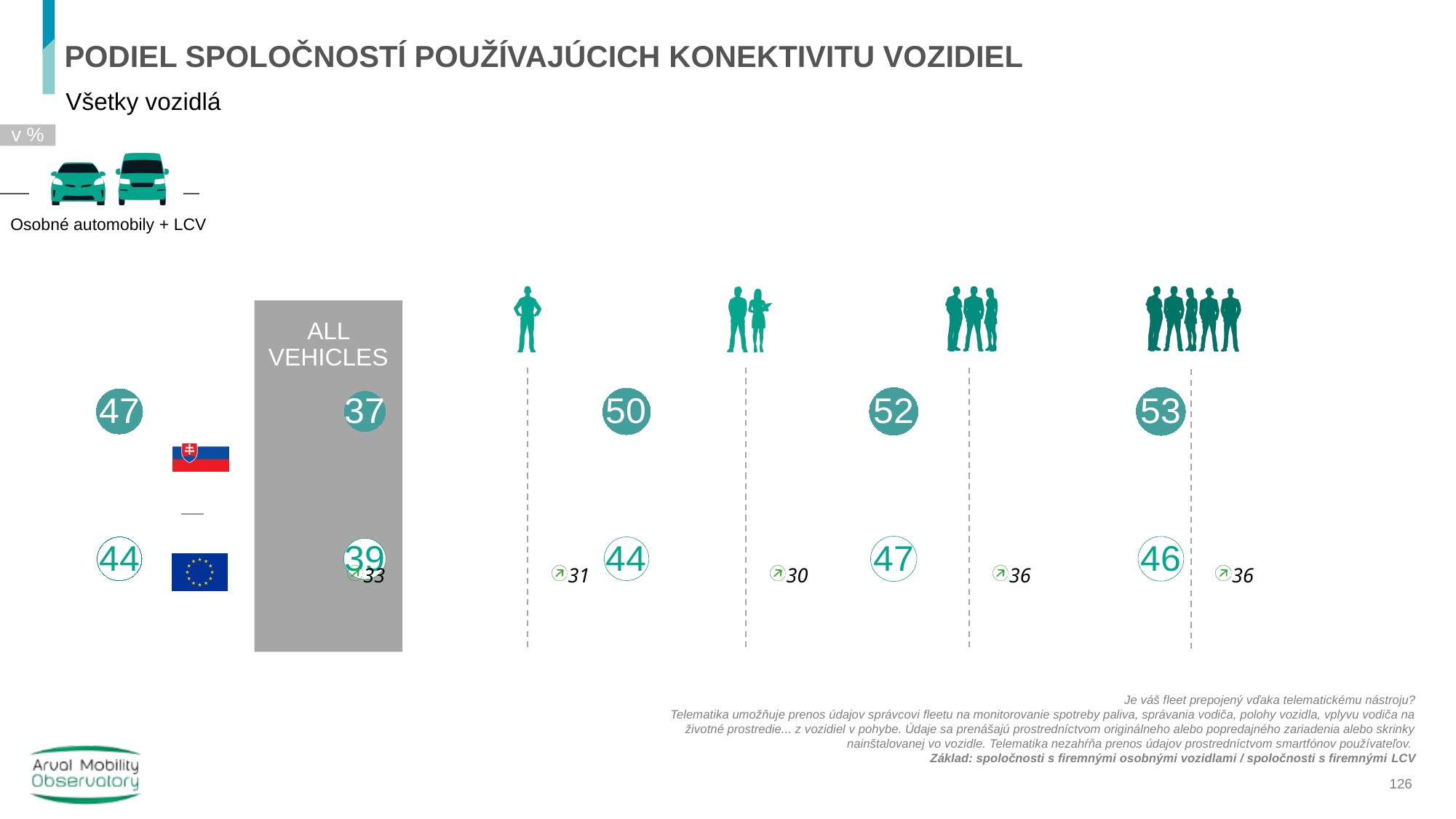
In the ALL VEHICLES column, what value is shown in the top row (Slovak flag row)? 37 What is the value in the leftmost column (Osobné automobily + LCV) for the EU flag row? 44 What is the difference between the Slovak flag value and the EU flag value in the ALL VEHICLES column? 2 In the rightmost column (five-person icon), which is larger: the Slovak flag value or the EU flag value? The Slovak flag value (53) What unit is indicated for the values on the slide? % What small italic value with an arrow is shown next to the ALL VEHICLES column? 33 Which column has the lowest value in the Slovak flag row? ALL VEHICLES, 37 What is the value in the rightmost column (five-person icon) for the Slovak flag row? 53 In the ALL VEHICLES column, what value is shown in the bottom row (EU flag row)? 39 Which column has the highest value in the Slovak flag row? The rightmost column (five-person icon), 53 What is the value in the rightmost column (five-person icon) for the EU flag row? 46 What is the value in the leftmost column (Osobné automobily + LCV) for the Slovak flag row? 47